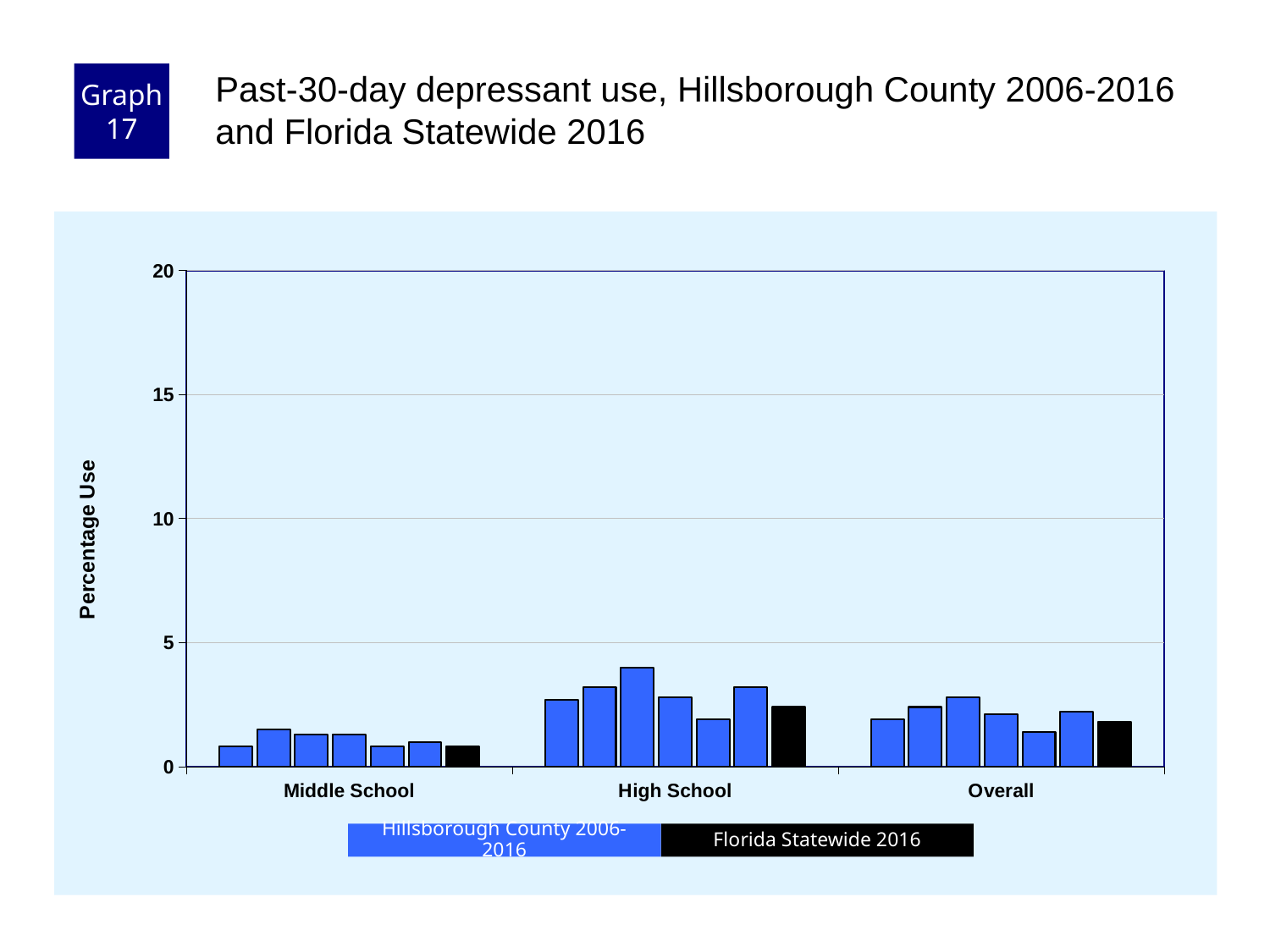
How many series does the legend list? 2 Is the Florida Statewide 2016 value for High School greater or less than 5? less Which is larger, the Florida Statewide 2016 value for Overall or for Middle School? Overall Is the tallest Hillsborough County bar for High School greater or less than 5? less Which series is shown in black in the legend? Florida Statewide 2016 Which is larger, the Florida Statewide 2016 value for High School or for Middle School? High School Which category has the lowest bars overall? Middle School What is the label of the y axis? Percentage Use How many categories are shown along the x axis? 3 Which category has the tallest bars overall? High School What kind of chart is shown on the slide? bar chart Is the Florida Statewide 2016 value for Middle School greater or less than 5? less